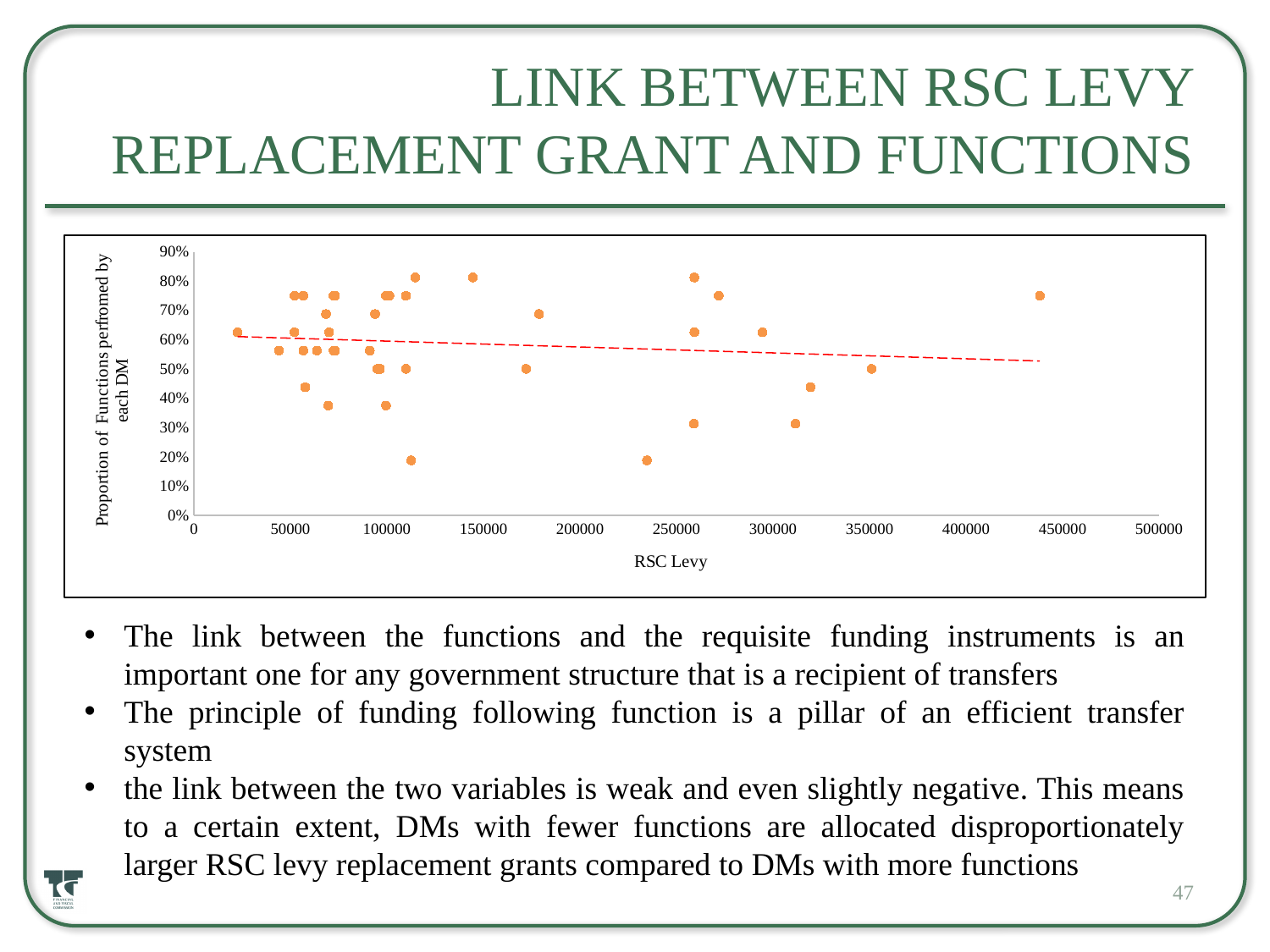
Is the RSC Levy of the rightmost point greater or less than 400000? greater Does the dashed trend line rise or fall as RSC Levy increases? fall Is the RSC Levy of the leftmost point greater or less than 50000? less Is the proportion of functions for the lowest point on the chart greater or less than 30%? less What is the highest value shown on the vertical axis of the chart? 90% Are there more points with RSC Levy below 150000 or above 150000? below 150000 What kind of chart is shown on the slide? scatter plot What is the title of the horizontal axis of the chart? RSC Levy